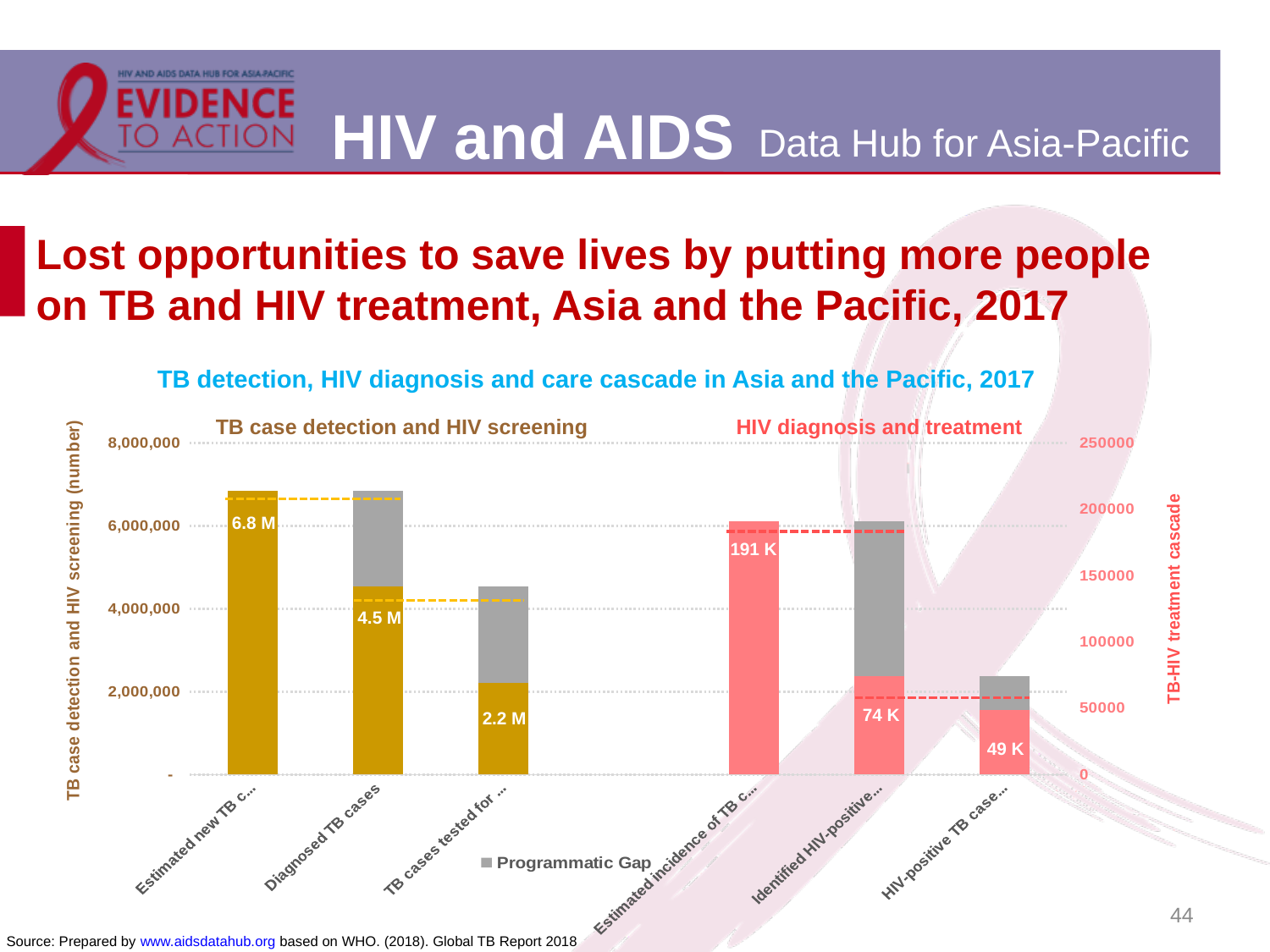
What is the value labelled on the Diagnosed TB cases bar? 4.5 M What is the value labelled on the HIV-positive TB cases bar? 49 K In the HIV diagnosis and treatment section, which category has the lowest labelled value? HIV-positive TB cases In the TB case detection and HIV screening section, which category has the highest labelled value? Estimated new TB cases Do the labelled values fall or rise from left to right within the TB case detection and HIV screening section? fall How many categories are shown along the x axis? 6 Is the total height of the Diagnosed TB cases bar (including the programmatic gap) greater or less than 6,000,000? greater What is the value labelled on the Identified HIV-positive bar? 74 K What type of chart is shown on the slide? bar chart What entry does the legend show? Programmatic Gap What is the chart title? TB detection, HIV diagnosis and care cascade in Asia and the Pacific, 2017 Which is larger, the labelled value for Estimated incidence of TB cases or for Identified HIV-positive? Estimated incidence of TB cases